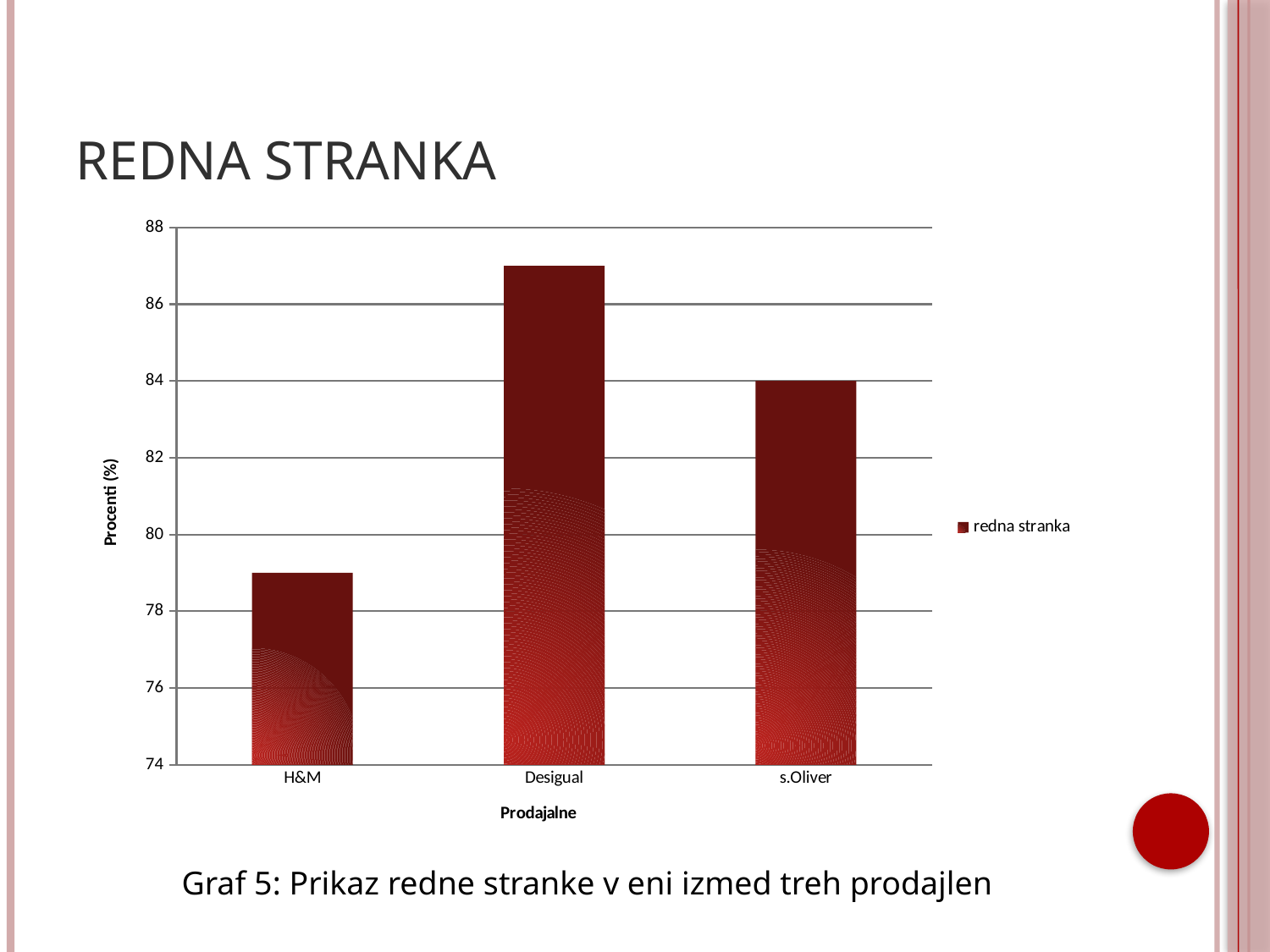
Which shop has the lowest value in the chart? H&M What kind of chart is shown on the slide? bar chart Is the value for Desigual greater or less than 86? greater What is the value for s.Oliver in the chart? 84 Which shop has the highest value in the chart? Desigual What is the label of the series in the chart legend? redna stranka What is the title of the y axis of the chart? Procenti (%) Which is larger, the value for Desigual or the value for s.Oliver? Desigual Is the value for H&M greater or less than 80? less How many categories (shops) are shown on the x axis of the chart? 3 How many series does the chart legend list? 1 Is the value for H&M greater or less than 78? greater